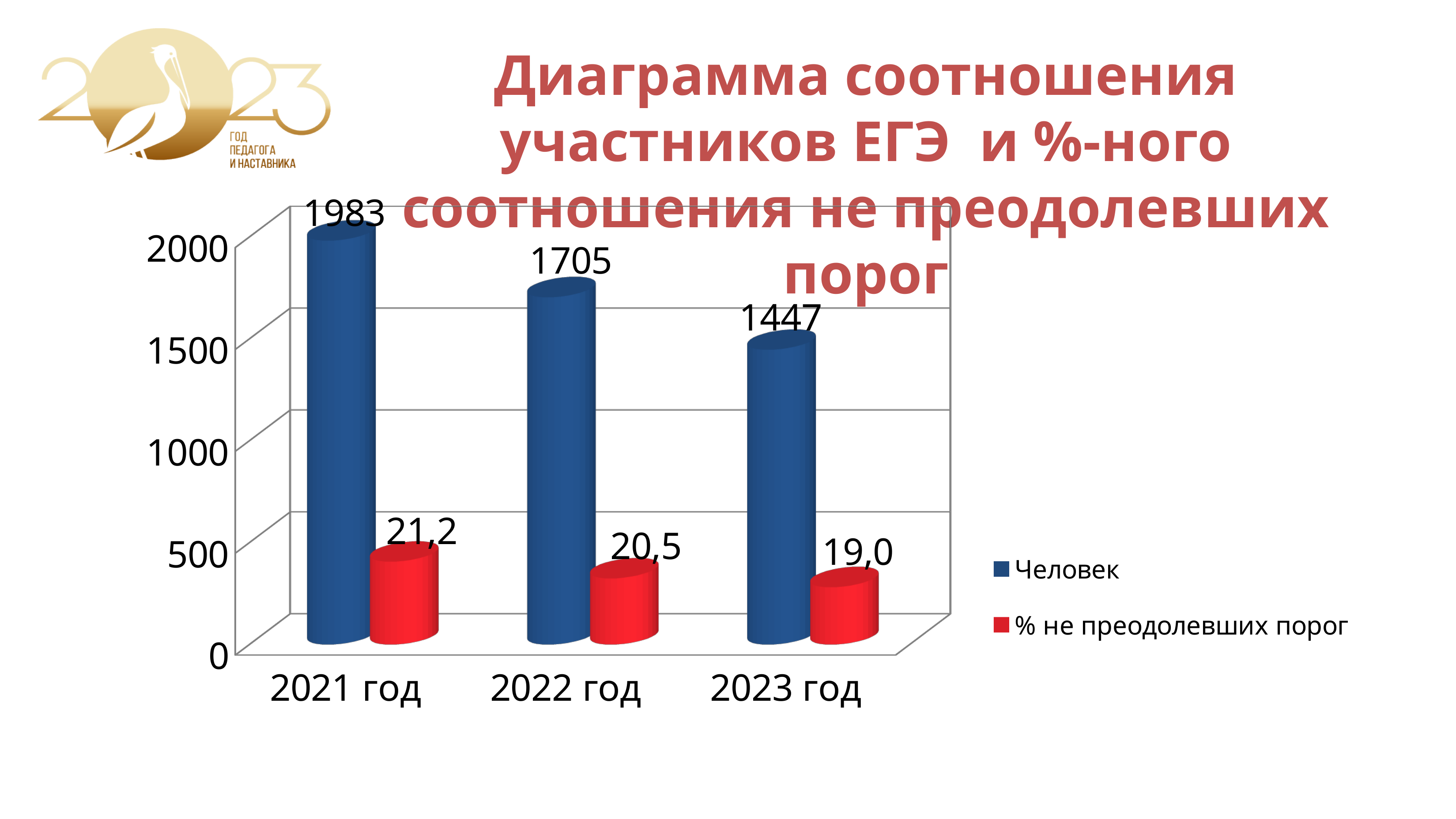
Which is larger: the Человек value for 2022 год or for 2023 год? 2022 год What is the value of the % не преодолевших порог series for 2023 год? 19,0 Do the values of the Человек series rise or fall from 2021 год to 2023 год? Fall What kind of chart is shown on the slide? Bar chart How many series does the legend list? 2 Which year has the highest value in the Человек series? 2021 год What is the value of the Человек series for 2023 год? 1447 What is the value of the % не преодолевших порог series for 2022 год? 20,5 What is the difference between the Человек values for 2021 год and 2023 год? 536 How many years are shown on the x axis? 3 Which year has the lowest value in the % не преодолевших порог series? 2023 год What is the value of the Человек series for 2021 год? 1983